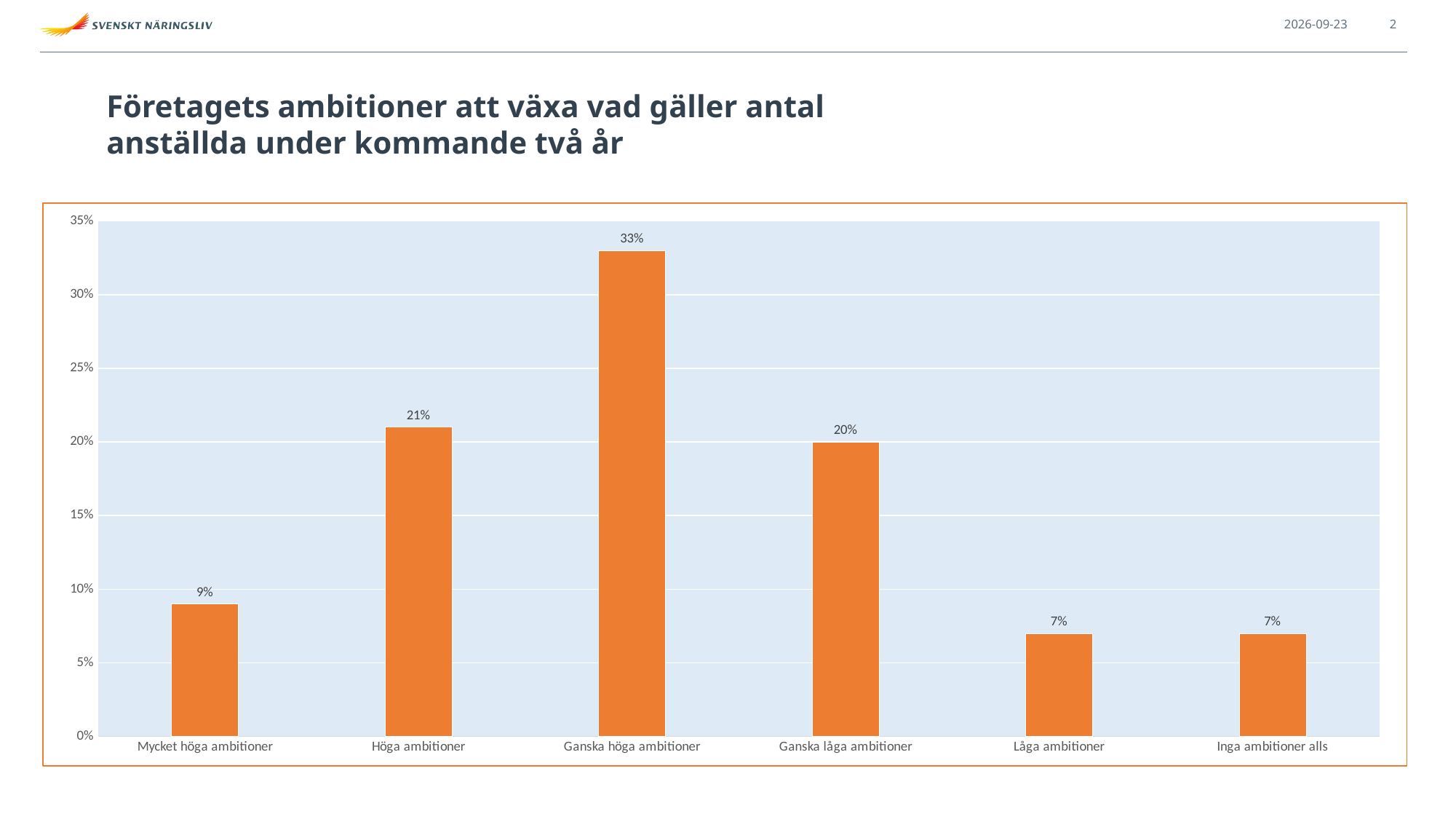
Is the value for Ganska höga ambitioner greater or less than 30%? greater What is the value for Ganska låga ambitioner? 20% What is the difference between Ganska höga ambitioner and Ganska låga ambitioner? 13% What is the value for Mycket höga ambitioner? 9% What is the value for Höga ambitioner? 21% Which category has the highest value? Ganska höga ambitioner What is the value for Låga ambitioner? 7% What kind of chart is shown on the slide? Bar chart What is the value for Ganska höga ambitioner? 33% What is the difference between Höga ambitioner and Mycket höga ambitioner? 12% How many categories are shown on the x axis? 6 Which is larger, Höga ambitioner or Mycket höga ambitioner? Höga ambitioner